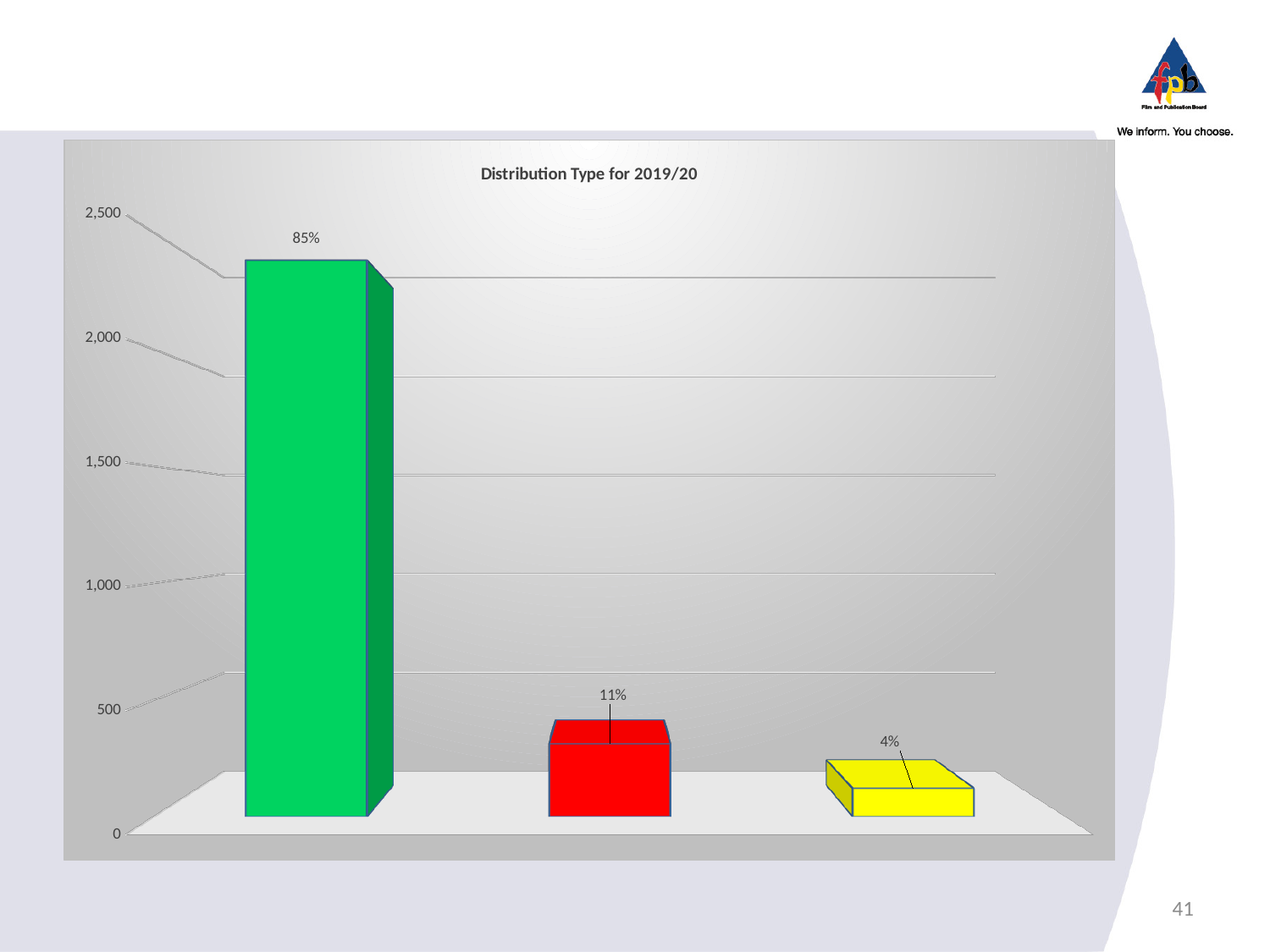
Is the value of the red bar greater or less than 500 on the vertical axis? less What data label is shown on the red bar (the middle bar)? 11% What is the difference in percentage points between the green bar's label and the red bar's label? 74% Do the bar values rise or fall from left to right across the chart? fall What is the title of the chart? Distribution Type for 2019/20 What kind of chart is shown on the slide? bar chart How many bars are plotted in the chart? 3 Which bar has the highest value? the green bar (first from the left) Which bar has the lowest value? the yellow bar (rightmost) What data label is shown on the green bar (the first bar from the left)? 85% What data label is shown on the yellow bar (the rightmost bar)? 4% Is the value of the green bar greater or less than 2,000 on the vertical axis? greater